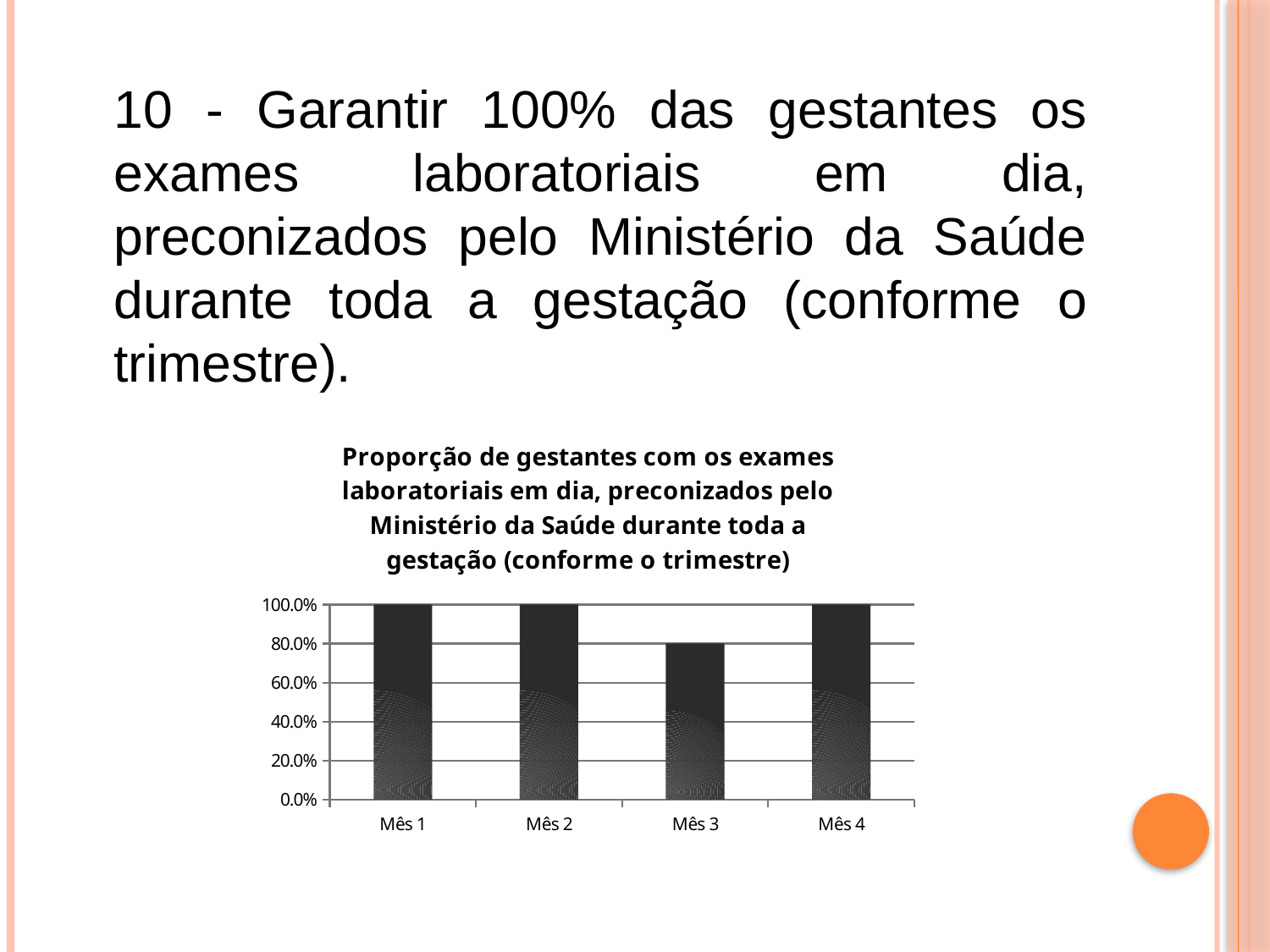
What is the highest value shown on the y axis? 100.0% What kind of chart is shown on the slide? bar chart What is the difference between the values for Mês 2 and Mês 3? 20.0% Which is larger, the value for Mês 2 or the value for Mês 3? Mês 2 What is the label of the first category on the x axis? Mês 1 Which month has the lowest value? Mês 3 How many months are shown on the x axis? 4 Is the value for Mês 3 greater or less than 60.0%? greater What is the value for Mês 1? 100.0% What is the value for Mês 3? 80.0% What is the value for Mês 4? 100.0%